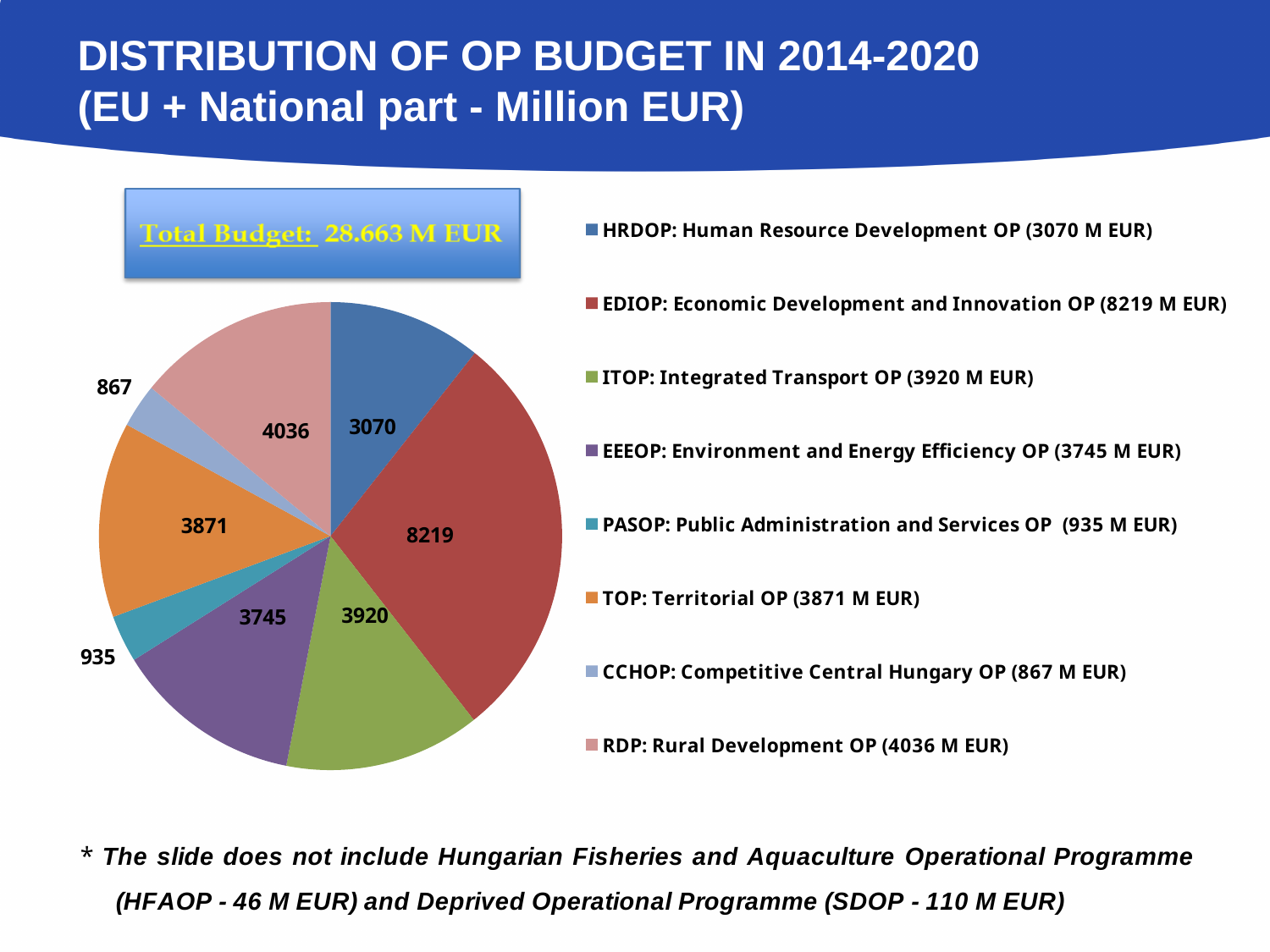
What is the value shown for TOP: Territorial OP? 3871 What total budget is stated in the box above the pie chart? 28.663 M EUR What is the value shown for EDIOP: Economic Development and Innovation OP? 8219 Which is larger, the value for HRDOP or the value for RDP? RDP What is the difference between the values for ITOP (3920) and EEEOP (3745)? 175 Which operational programme has the largest slice of the pie? EDIOP: Economic Development and Innovation OP Which operational programme is shown in the orange slice? TOP: Territorial OP What is the value shown for PASOP: Public Administration and Services OP? 935 What kind of chart is shown on the slide? pie chart What is the difference between the values for EDIOP (8219) and RDP (4036)? 4183 How many slices does the pie chart have? 8 Which operational programme has the smallest slice of the pie? CCHOP: Competitive Central Hungary OP